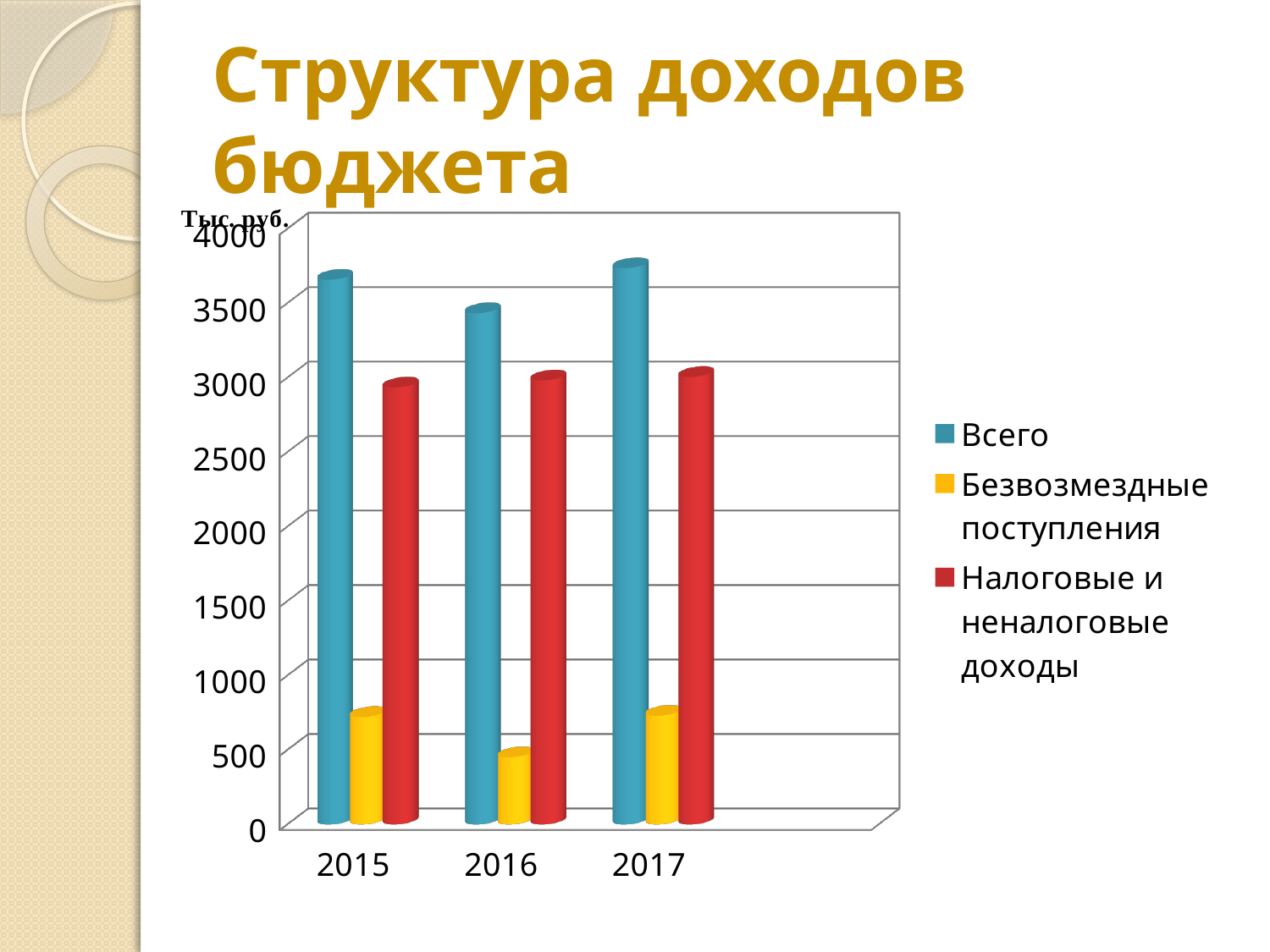
Which is larger, the value for Всего in 2015 or in 2016? 2015 Is the value for Налоговые и неналоговые доходы in 2017 greater or less than 2500? greater In which year is the value for Всего the lowest? 2016 In which year is the value for Безвозмездные поступления the lowest? 2016 How many years are shown on the x axis? 3 How many series does the legend list? 3 Does the value for Безвозмездные поступления rise or fall from 2015 to 2016? fall What kind of chart is shown on the slide? Bar chart Is the value for Безвозмездные поступления in 2015 greater or less than 1000? less Is the value for Всего in 2015 greater or less than 3500? greater What unit is indicated on the vertical axis? Тыс. руб. Which series is shown in red in the legend? Налоговые и неналоговые доходы